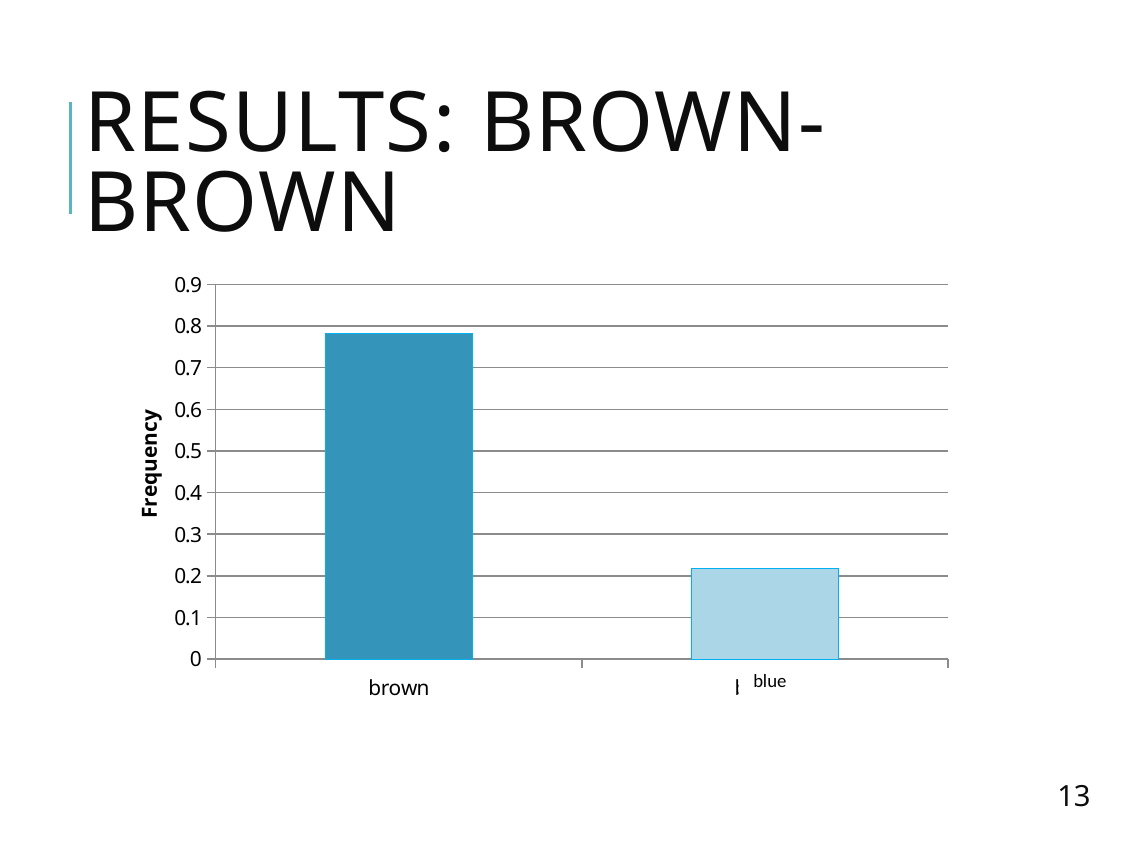
What kind of chart is shown on the slide? bar chart Is the frequency for blue greater or less than 0.3? less How many categories are plotted on the chart? 2 Is the frequency for brown greater or less than 0.8? less Which has a larger frequency, brown or blue? brown Which category has the lowest frequency? blue What is the label of the vertical axis? Frequency Which category has the highest frequency? brown Is the frequency for brown greater or less than 0.7? greater What is the highest value shown on the vertical axis? 0.9